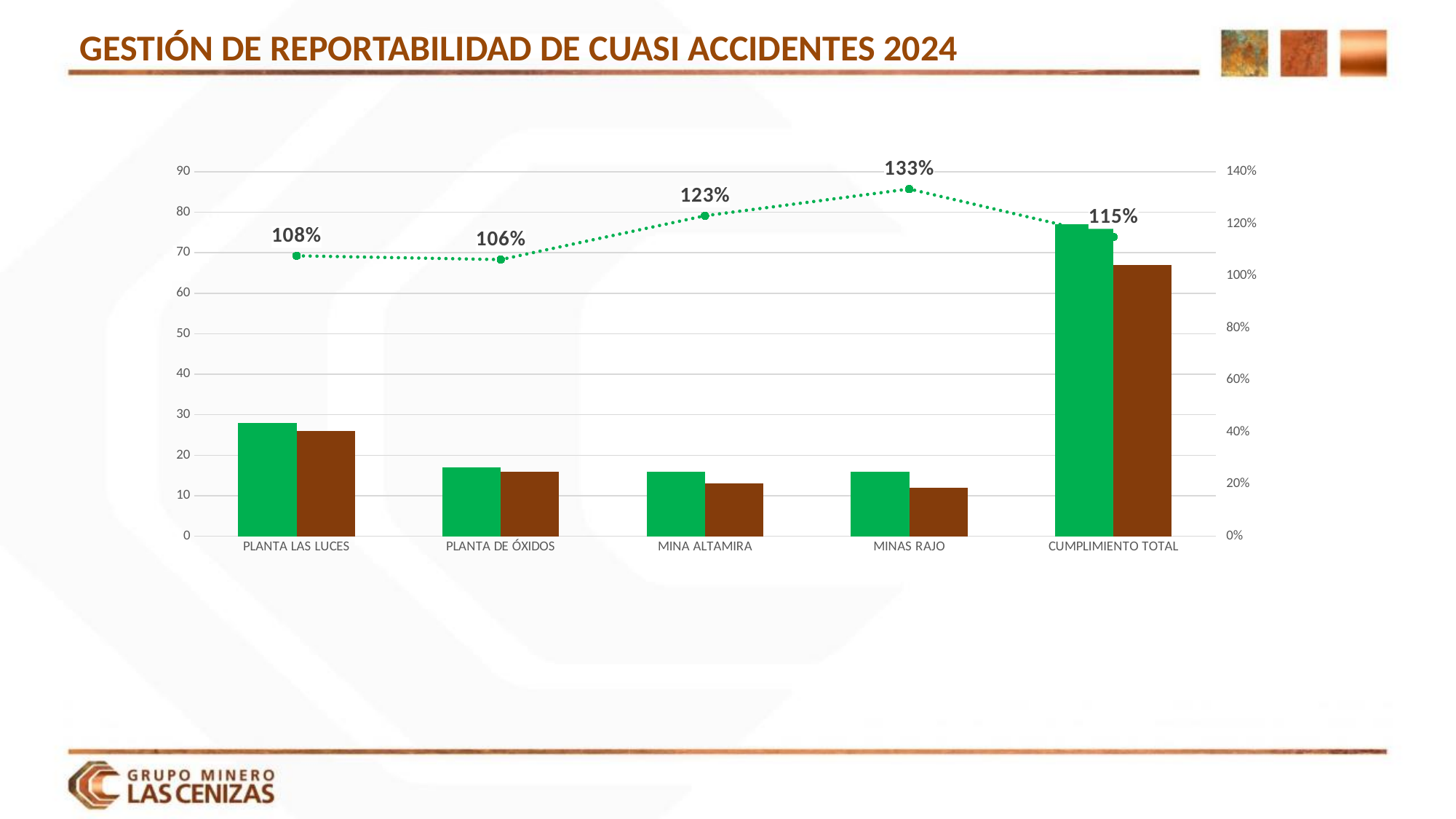
Is the value of the brown bar for MINA ALTAMIRA greater or less than 20? less What is the title of the slide? GESTIÓN DE REPORTABILIDAD DE CUASI ACCIDENTES 2024 What percentage is shown for MINAS RAJO on the dotted line? 133% What percentage is shown for PLANTA DE ÓXIDOS on the dotted line? 106% What percentage is shown for CUMPLIMIENTO TOTAL on the dotted line? 115% What is the difference between the percentages for MINAS RAJO and MINA ALTAMIRA? 10% How many categories are shown on the x axis? 5 Which category has the highest percentage on the dotted line? MINAS RAJO What kind of chart is shown on the slide? Combined bar and line chart Which category has the lowest percentage on the dotted line? PLANTA DE ÓXIDOS Is the value of the green bar for CUMPLIMIENTO TOTAL greater or less than 70? greater Which has a higher percentage on the dotted line, PLANTA LAS LUCES or MINA ALTAMIRA? MINA ALTAMIRA